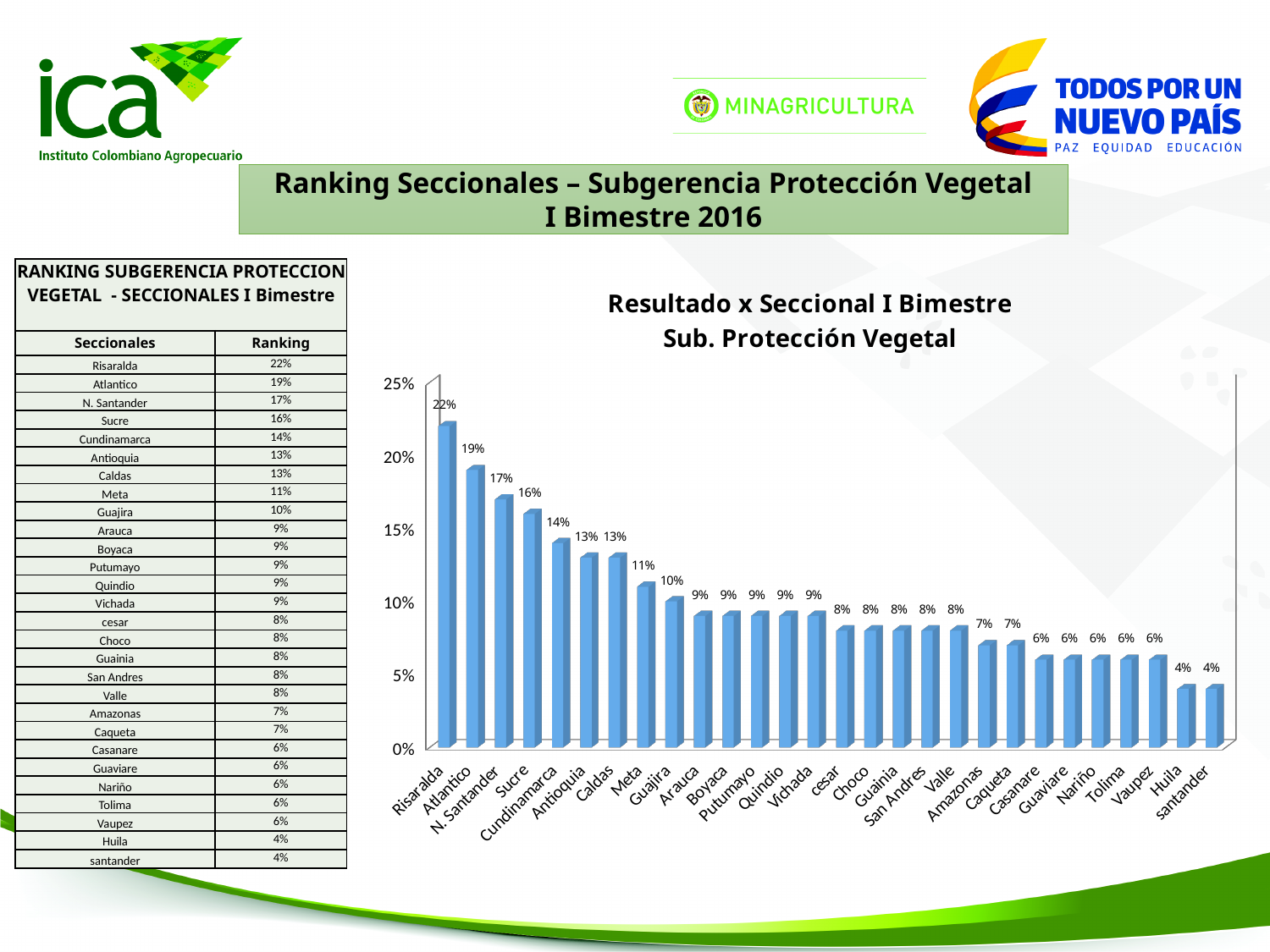
How many seccionales (categories) are plotted in the chart? 28 What is the value for Sucre in the chart? 16% What is the value for Guajira in the chart? 10% What is the difference between the values for N. Santander and Cundinamarca? 3% Which seccional has the highest value in the chart? Risaralda Do the values generally rise or fall from left to right along the x axis? Fall What is the difference between the values for Risaralda and Atlantico? 3% What is the title of the chart? Resultado x Seccional I Bimestre Sub. Protección Vegetal Which has a larger value, Sucre or Cundinamarca? Sucre What is the value for Meta in the chart? 11% What type of chart is shown on the slide? Bar chart What is the value for Amazonas in the chart? 7%